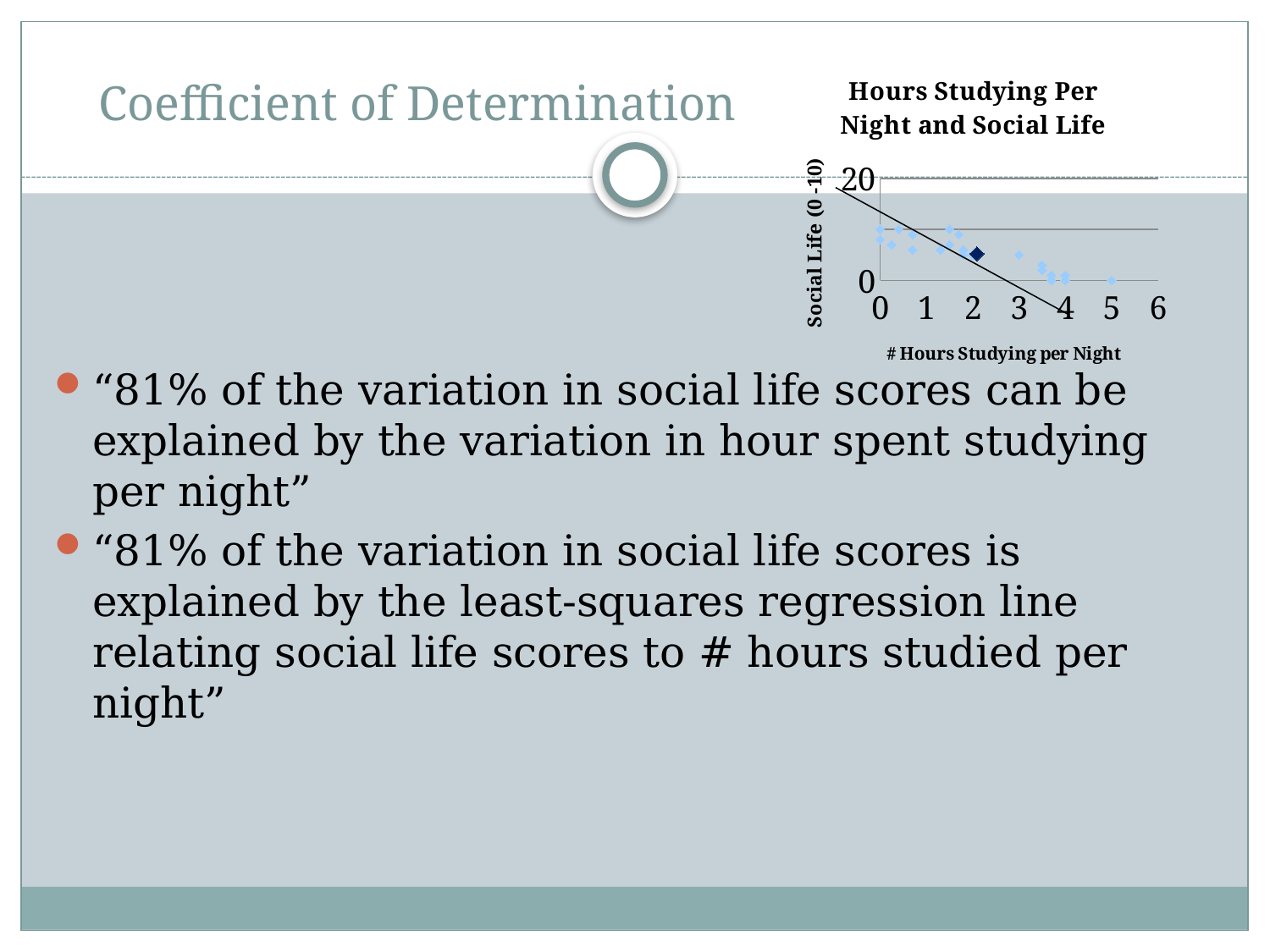
Is the social life value for the point at 0 hours studying greater or less than 20? less What kind of chart is shown on the slide? scatter chart What is the title of the chart on the slide? Hours Studying Per Night and Social Life As the number of hours studying per night increases, do the social life values rise or fall? fall Does the trend line in the chart slope upward or downward from left to right? downward Is the social life value for the point at 5 hours studying greater or less than 20? less What is the highest value shown on the x axis of the chart? 6 What is the label of the x axis of the chart? # Hours Studying per Night